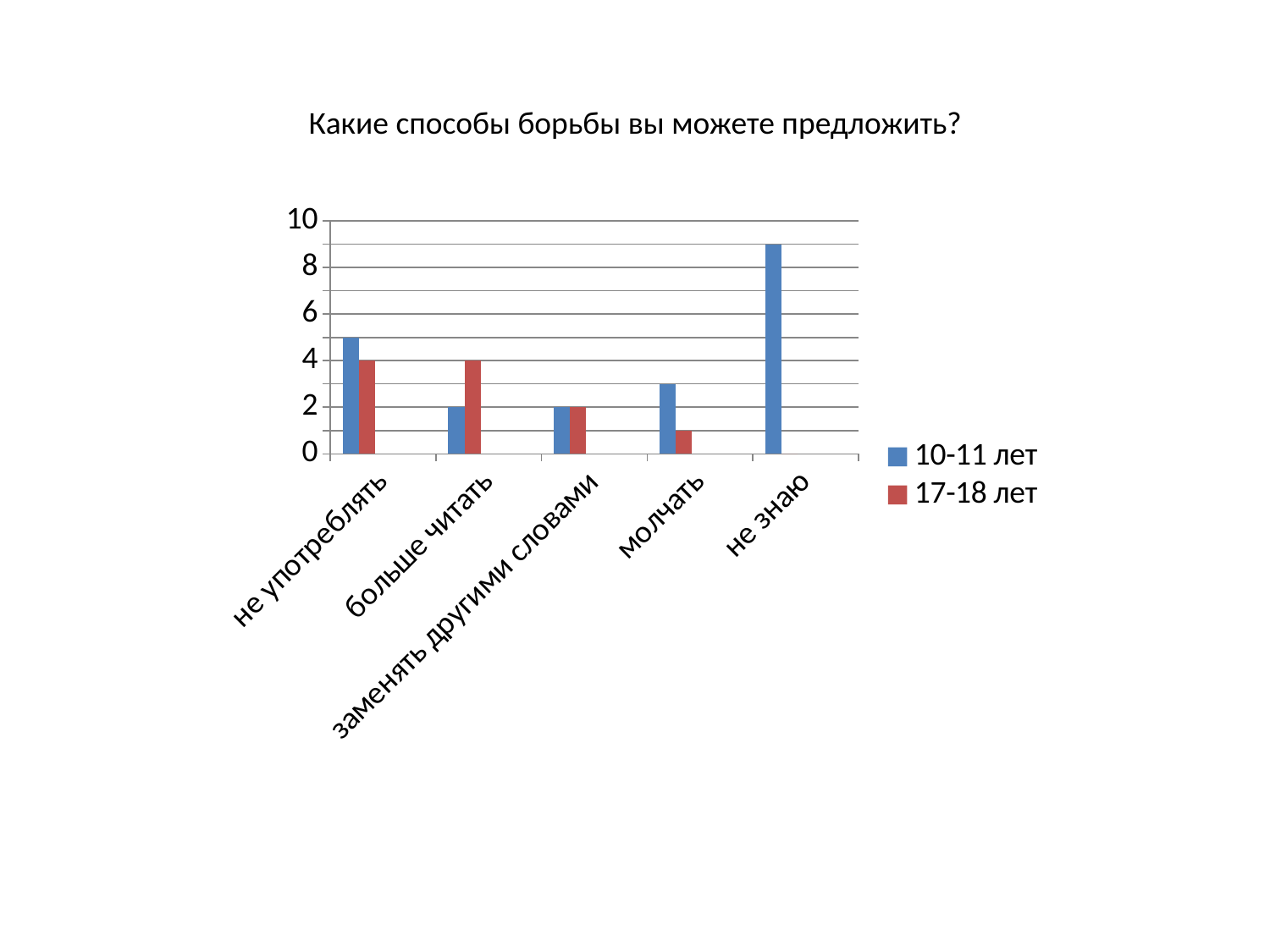
Is the value for "не знаю" in the 10-11 лет series greater or less than 8? greater Is the value for "молчать" in the 17-18 лет series greater or less than 2? less What is the value for "больше читать" in the 10-11 лет series? 2 Which category has the highest value in the 10-11 лет series? не знаю How many categories are shown on the x axis? 5 What is the value for "не употреблять" in the 17-18 лет series? 4 What is the value for "заменять другими словами" in the 17-18 лет series? 2 What kind of chart is shown on the slide? bar chart What is the difference between the 17-18 лет and 10-11 лет values for "больше читать"? 2 For "больше читать", which series has the larger value, 10-11 лет or 17-18 лет? 17-18 лет What is the title of the chart? Какие способы борьбы вы можете предложить? How many series does the legend list? 2